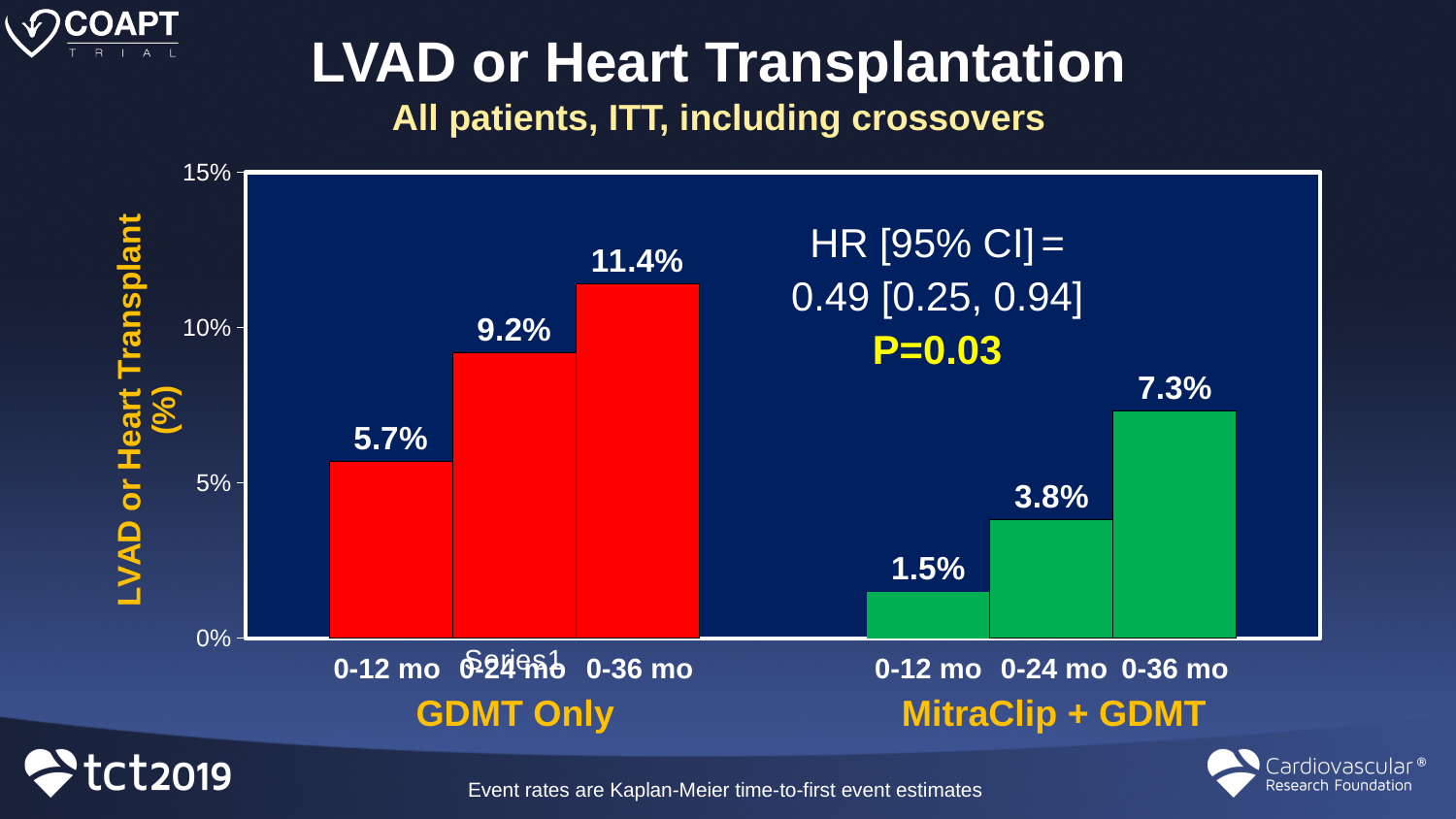
Which bar has the lowest value on the chart? 0-12 mo, MitraClip + GDMT Do the values in the MitraClip + GDMT group rise or fall from 0-12 mo to 0-36 mo? Rise How many bars are plotted on the chart in total? 6 What is the LVAD or heart transplant rate at 0-12 mo for the MitraClip + GDMT group? 1.5% What is the LVAD or heart transplant rate at 0-36 mo for the GDMT Only group? 11.4% What is the difference between the 0-36 mo values for GDMT Only and MitraClip + GDMT? 4.1% Which bar has the highest value on the chart? 0-36 mo, GDMT Only Is the 0-36 mo value for GDMT Only greater or less than 10%? greater Which is larger: the 0-24 mo value for GDMT Only or the 0-36 mo value for MitraClip + GDMT? 0-24 mo for GDMT Only What is the value shown for 0-24 mo in the MitraClip + GDMT group? 3.8% What is the difference between the 0-24 mo and 0-12 mo values in the GDMT Only group? 3.5% What kind of chart is shown on the slide? Bar chart